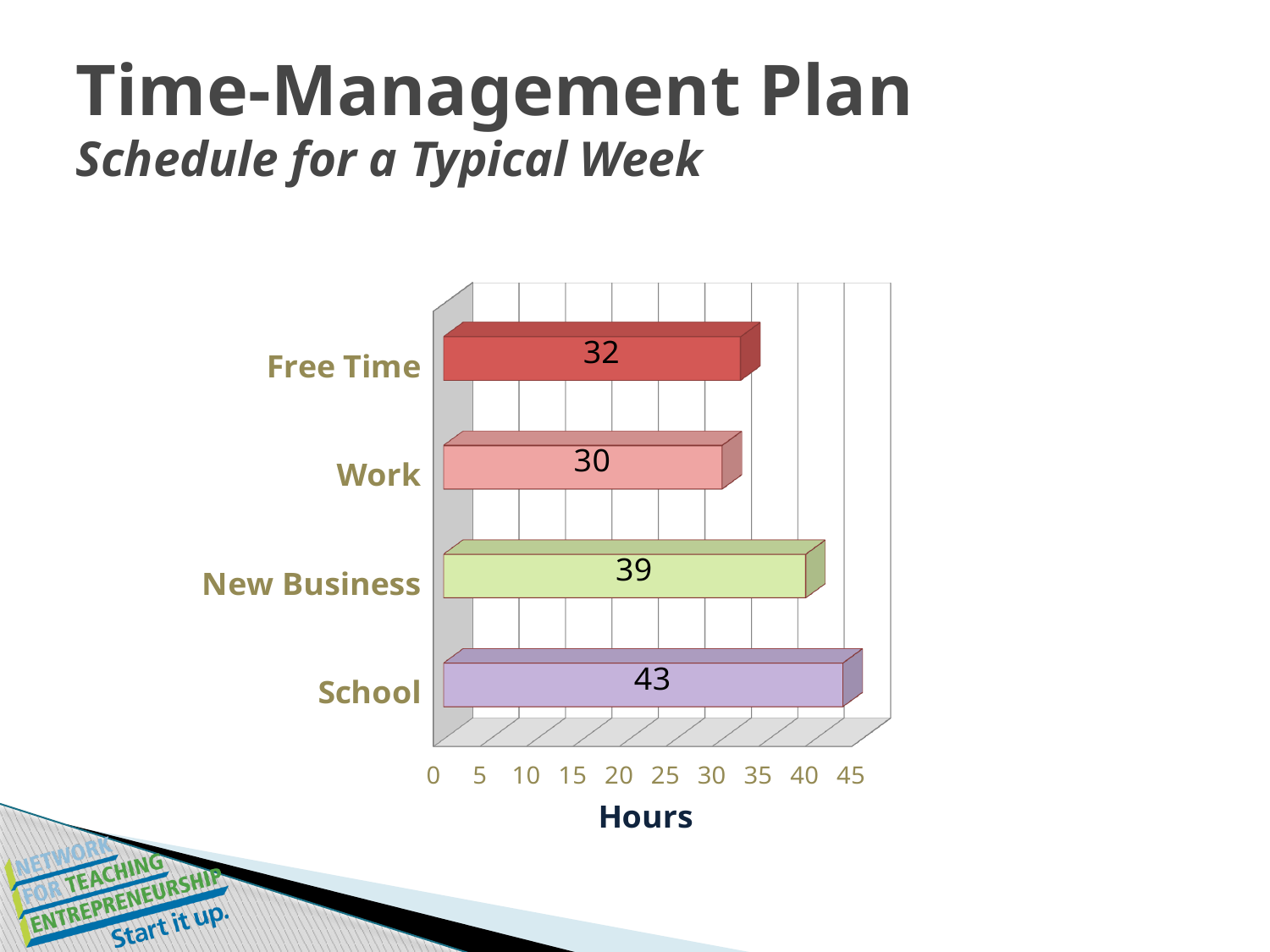
How many hours are allocated to Work? 30 What is the difference in hours between School and Work? 13 How many hours are allocated to School? 43 Which category has the fewest hours? Work Which category has the most hours? School What kind of chart is shown on the slide? Bar chart What is the difference in hours between New Business and Free Time? 7 How many hours are allocated to Free Time? 32 What is the label of the horizontal axis? Hours How many categories are shown in the chart? 4 Which has more hours, Free Time or Work? Free Time How many hours are allocated to New Business? 39